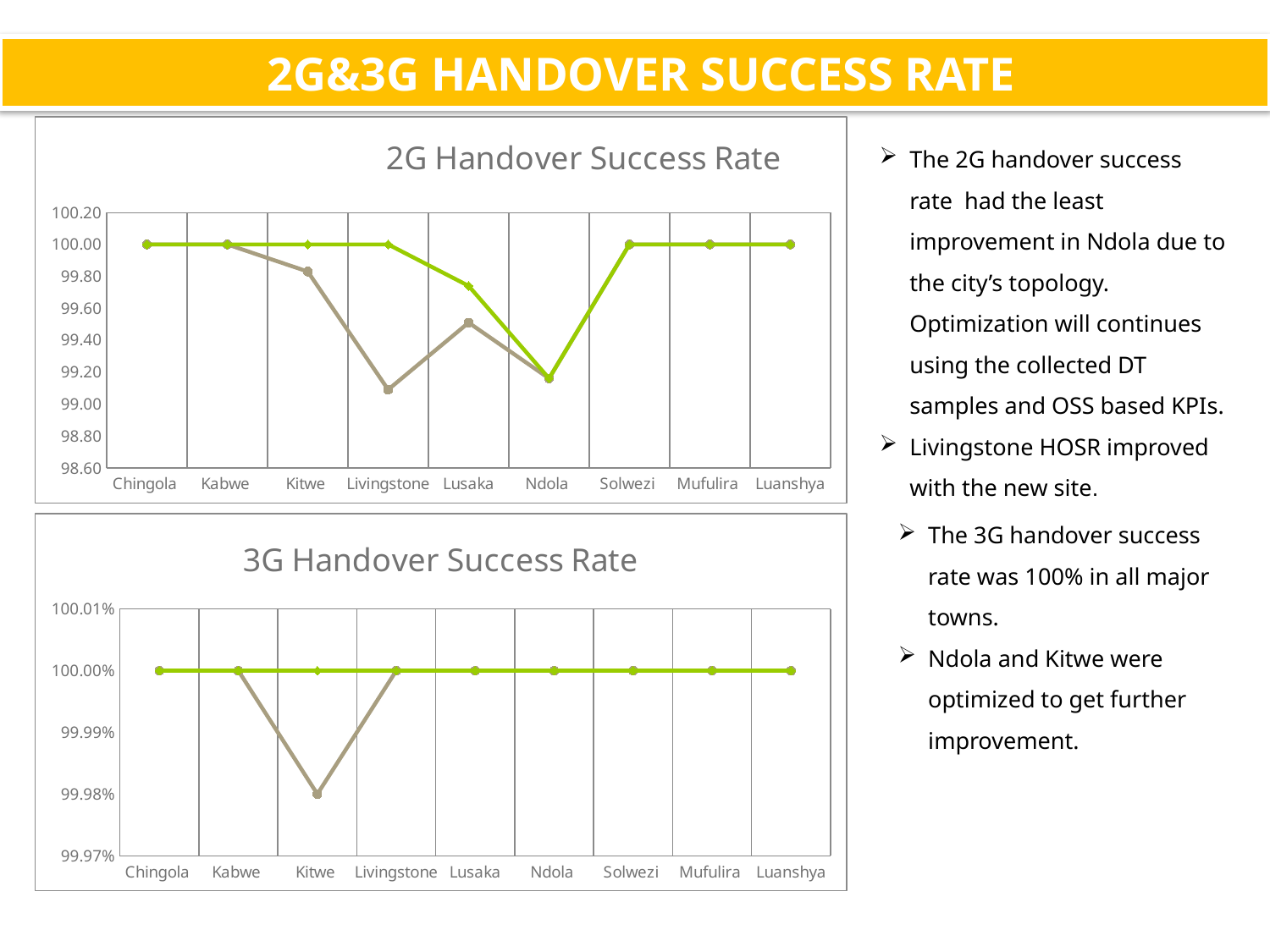
In the 2G Handover Success Rate chart, is the green line's value for Lusaka greater or less than 99.60? greater In the 3G Handover Success Rate chart, what is the value of the grey line for Kitwe? 99.98% In the 2G Handover Success Rate chart, is the grey line's value for Livingstone greater or less than 99.20? less In the 3G Handover Success Rate chart, what is the value of the green line for Ndola? 100.00% In the 2G Handover Success Rate chart, which city has the lowest value on the green line? Ndola In the 3G Handover Success Rate chart, which city has the lowest value on the grey line? Kitwe In the 2G Handover Success Rate chart, is the grey line's value for Lusaka greater or less than 99.40? greater What kind of chart is the 2G Handover Success Rate chart? line chart What is the title of the lower chart on the slide? 3G Handover Success Rate How many cities are shown on the x axis of the 2G Handover Success Rate chart? 9 In the 2G Handover Success Rate chart, which line has the higher value for Kitwe, the green line or the grey line? the green line In the 2G Handover Success Rate chart, what is the value of the green line for Chingola? 100.00